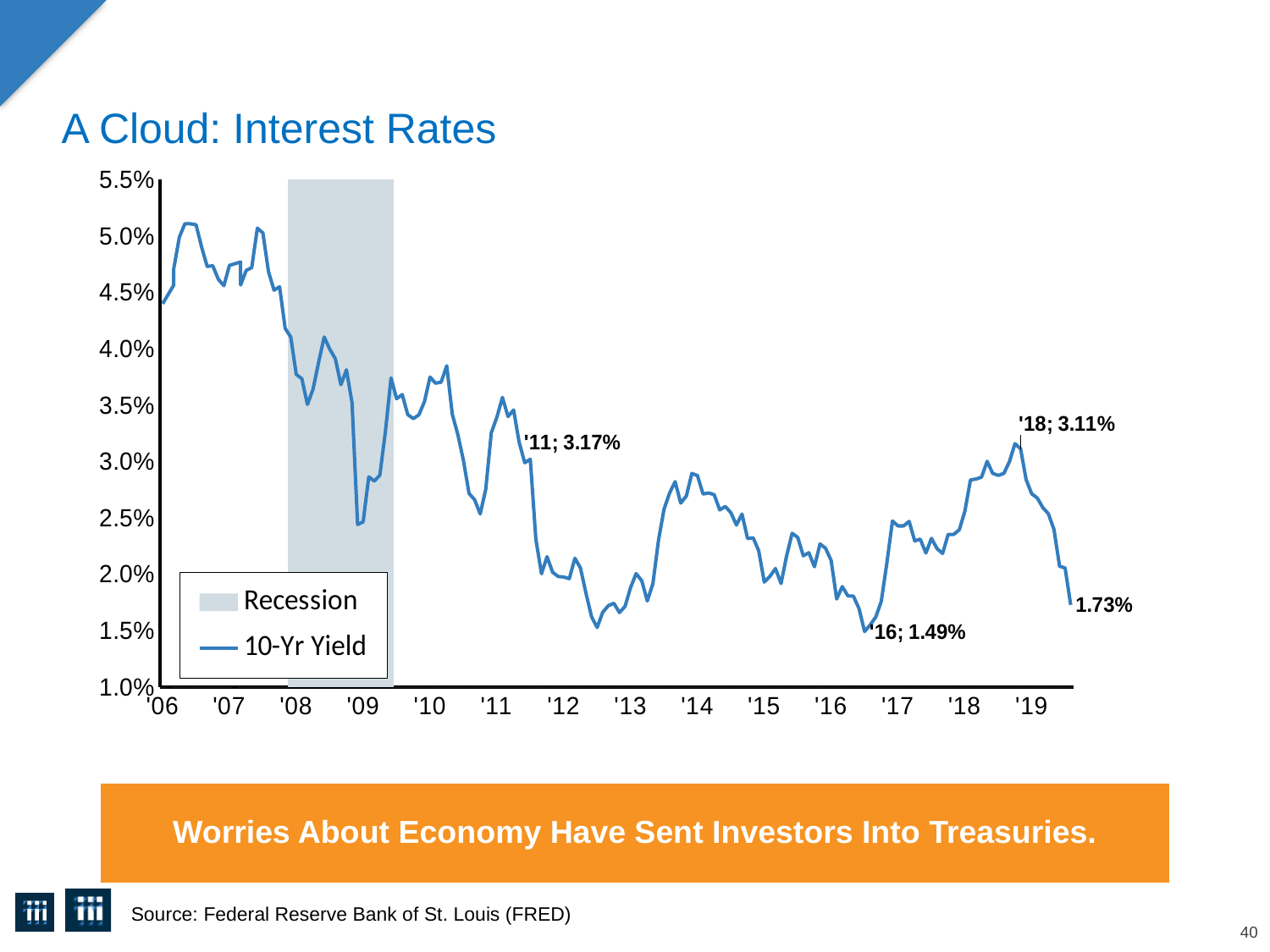
What is the 10-Yr Yield value labeled at '11? 3.17% What is the 10-Yr Yield value labeled at '16? 1.49% What is the 10-Yr Yield value labeled at '18? 3.11% Is the lowest point of the 10-Yr Yield during '12 greater or less than 2.0%? less How many entries does the legend list? 2 What kind of chart is shown on the slide? line chart What is the final labeled value of the 10-Yr Yield at the right end of the line? 1.73% Does the 10-Yr Yield overall rise or fall from '06 to '19? fall What is the difference between the labeled '11 value and the labeled '16 value of the 10-Yr Yield? 1.68 percentage points Which labeled value is larger, the '11 value or the '18 value? '11 (3.17%) Is the 10-Yr Yield at the start of '06 greater or less than 4.0%? greater What does the grey shaded area on the chart represent? Recession